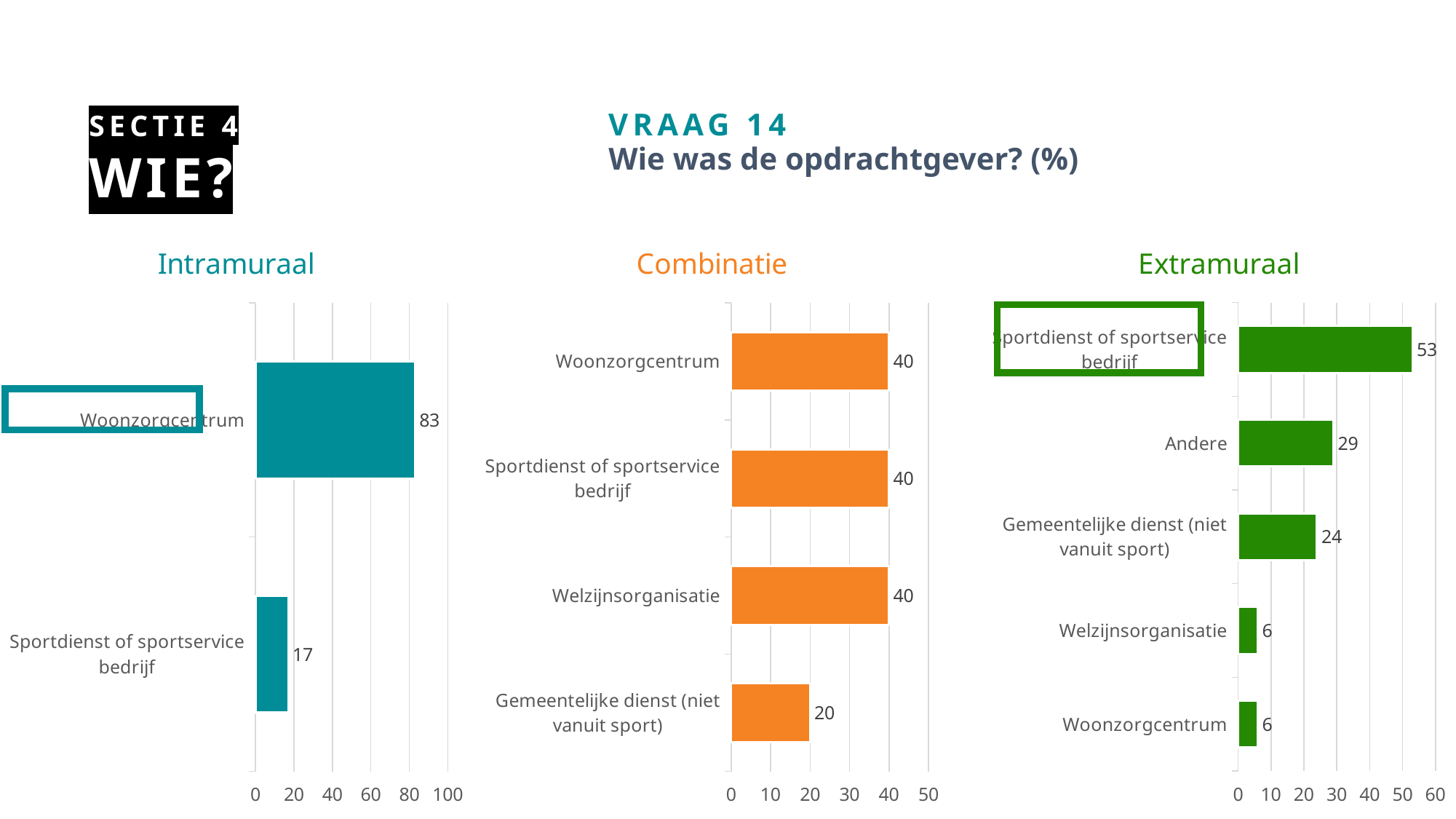
In the Extramuraal chart, which is larger: Andere or Welzijnsorganisatie? Andere How many categories does the Combinatie chart show? 4 In the Extramuraal chart, what is the value for Sportdienst of sportservice bedrijf? 53 In the Intramuraal chart, what is the value for Woonzorgcentrum? 83 In the Intramuraal chart, what is the value for Sportdienst of sportservice bedrijf? 17 How many categories does the Extramuraal chart show? 5 In the Combinatie chart, which category has the lowest value? Gemeentelijke dienst (niet vanuit sport) In the Extramuraal chart, what is the difference between Andere and Gemeentelijke dienst (niet vanuit sport)? 5 What kind of chart is the Combinatie chart? Bar chart In the Combinatie chart, what is the value for Gemeentelijke dienst (niet vanuit sport)? 20 In the Intramuraal chart, what is the difference between Woonzorgcentrum and Sportdienst of sportservice bedrijf? 66 In the Extramuraal chart, which category has the highest value? Sportdienst of sportservice bedrijf